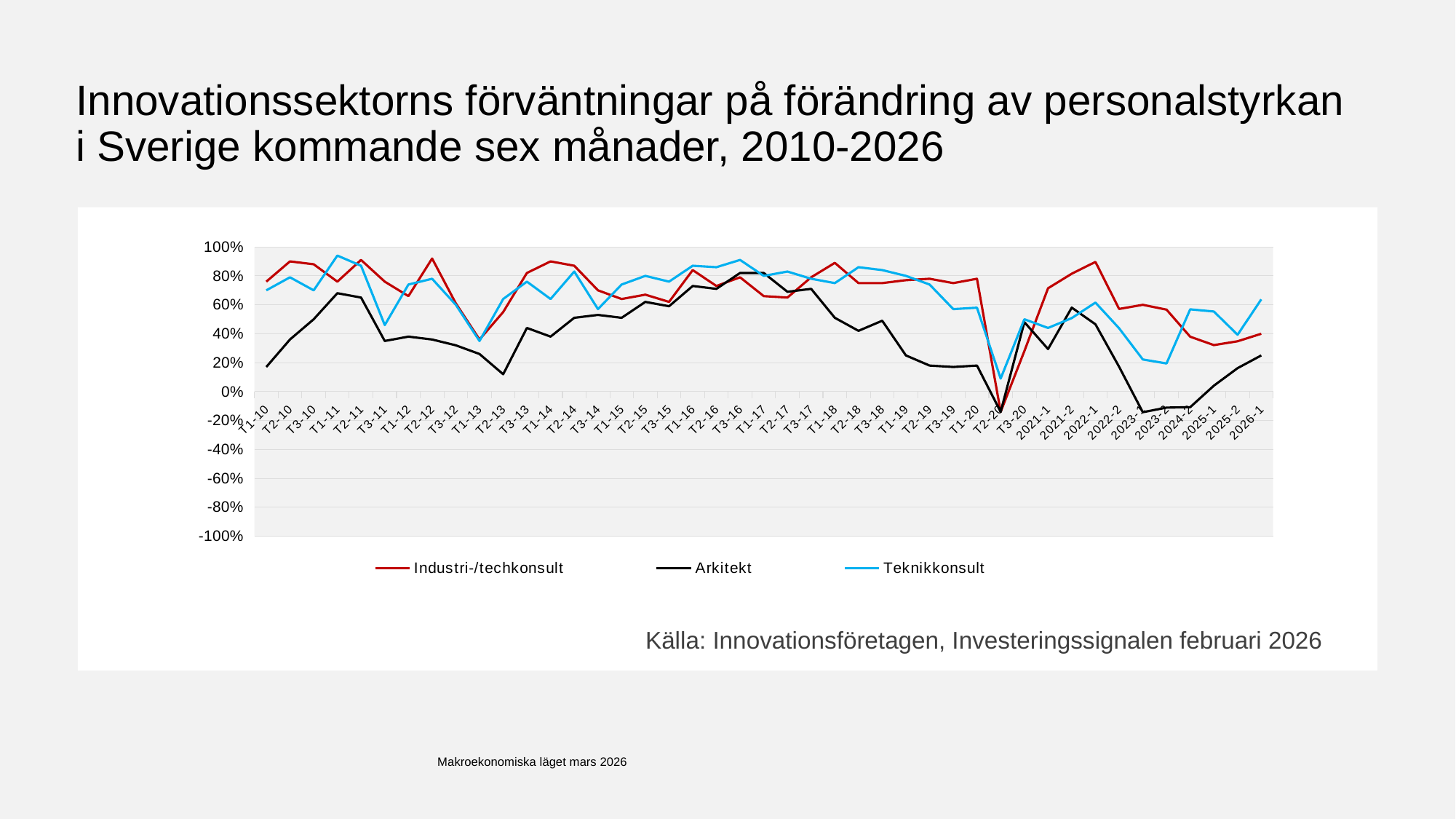
Is the value for Teknikkonsult at T2-20 greater or less than 40%? less What kind of chart is shown on the slide? Line chart Does the Arkitekt series rise or fall from 2023-1 to 2026-1? Rise At 2026-1, which series has the higher value, Teknikkonsult or Arkitekt? Teknikkonsult Which series is drawn in red in the chart? Industri-/techkonsult How many time periods are shown along the x axis of the chart? 43 Is the value for Teknikkonsult at 2026-1 greater or less than 40%? greater At which period does the Teknikkonsult series reach its lowest value? T2-20 Is the value for Industri-/techkonsult at T2-20 greater or less than 0%? less How many series does the legend list? 3 At T1-10, which series has the higher value, Industri-/techkonsult or Arkitekt? Industri-/techkonsult